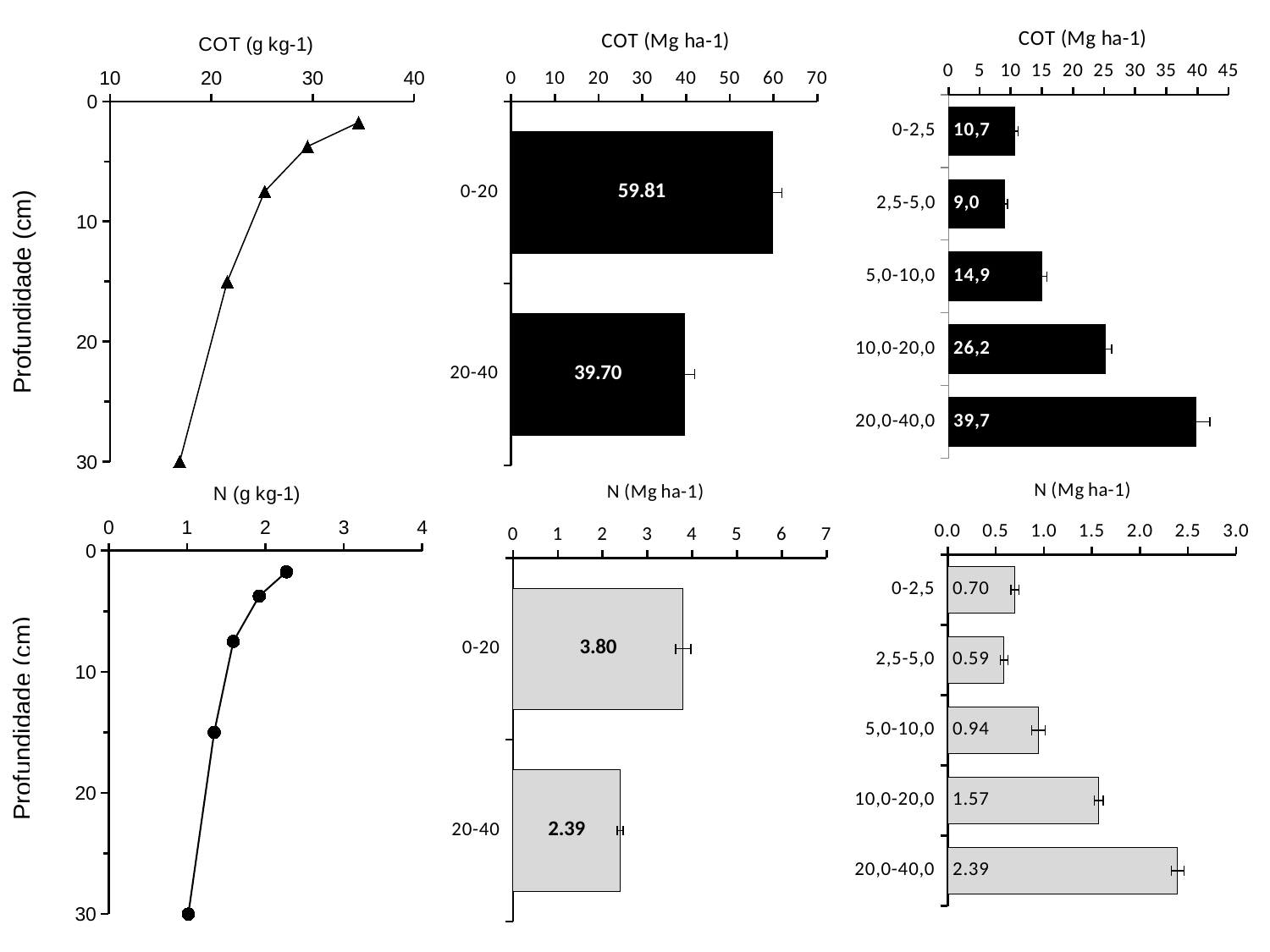
In the top-middle bar chart titled COT (Mg ha-1), what is the value for the 0-20 depth? 59.81 In the bottom-middle bar chart titled N (Mg ha-1), what is the value for the 20-40 depth? 2.39 In the bottom-right bar chart titled N (Mg ha-1), what is the value for the 10,0-20,0 depth? 1.57 What kind of chart is the top-left chart titled COT (g kg-1)? line chart In the top-middle bar chart titled COT (Mg ha-1), what is the difference between the 0-20 and 20-40 values? 20.11 In the top-right bar chart titled COT (Mg ha-1), which depth has the highest value? 20,0-40,0 In the top-middle bar chart titled COT (Mg ha-1), what is the value for the 20-40 depth? 39.70 In the top-right bar chart titled COT (Mg ha-1), what is the value for the 5,0-10,0 depth? 14,9 How many depth categories are shown in the top-right bar chart titled COT (Mg ha-1)? 5 In the bottom-right bar chart titled N (Mg ha-1), which is larger, the value for 0-2,5 or the value for 2,5-5,0? 0-2,5 In the top-right bar chart titled COT (Mg ha-1), which depth has the lowest value? 2,5-5,0